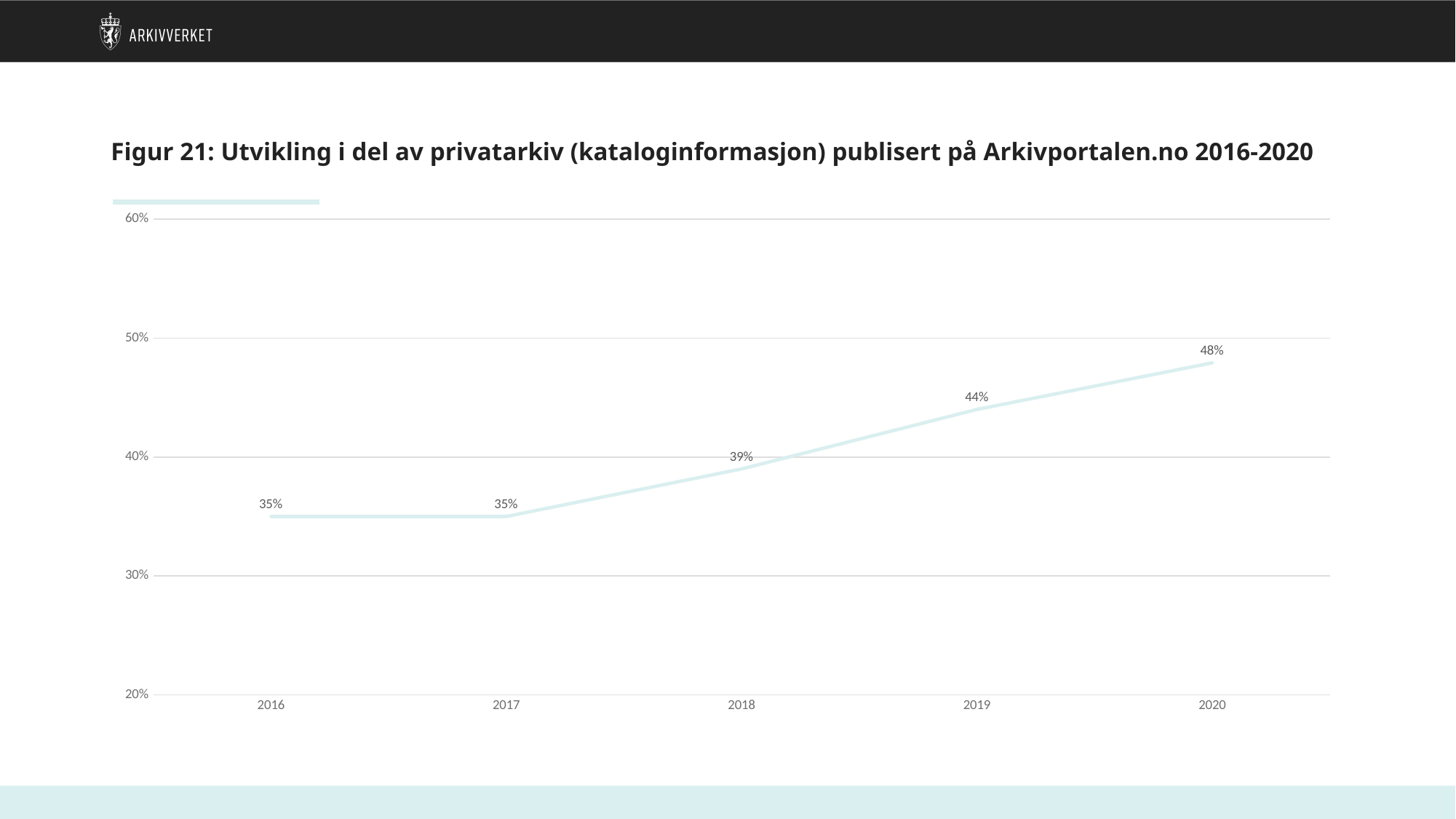
Which is larger, the value for 2019 or the value for 2018? 2019 Which year has the highest value? 2020 What is the value for 2016? 35% What is the value for 2018? 39% What is the difference between the values for 2020 and 2016? 13% Is the value for 2019 greater or less than 40%? greater Is the value for 2020 greater or less than 50%? less What is the value for 2020? 48% How many years are plotted on the chart? 5 Do the values rise or fall from 2017 to 2020? rise What is the difference between the values for 2019 and 2018? 5% What kind of chart is shown on the slide? line chart